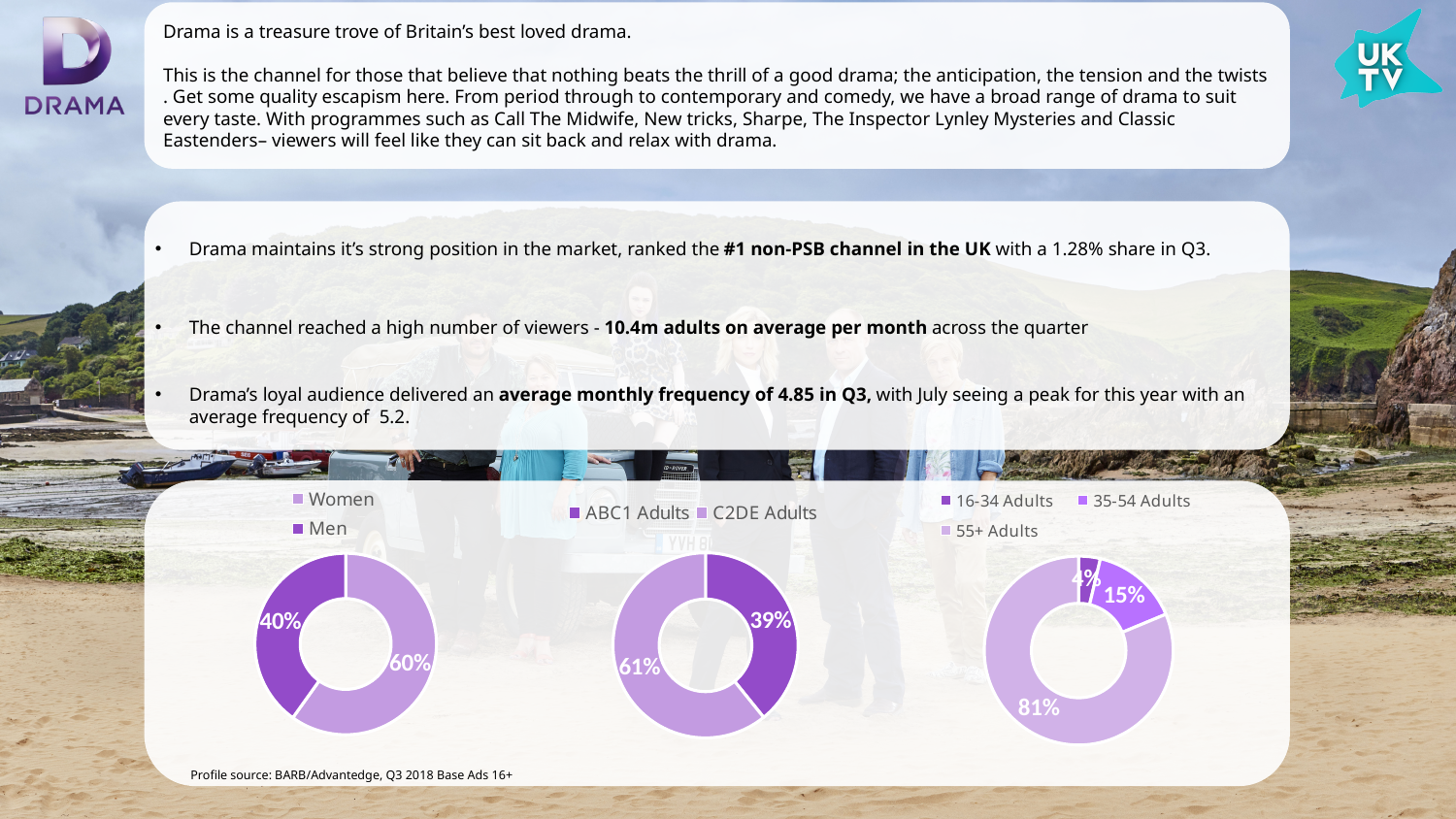
In the middle donut chart (ABC1/C2DE Adults), what share is shown for C2DE Adults? 61% In the right donut chart (age groups), what share is shown for 55+ Adults? 81% In the left donut chart (Women/Men), what share is shown for Women? 60% In the left donut chart (Women/Men), what share is shown for Men? 40% In the middle donut chart (ABC1/C2DE Adults), what share is shown for ABC1 Adults? 39% How many series does the legend of the right donut chart (age groups) list? 3 In the middle donut chart (ABC1/C2DE Adults), which group has the larger share, ABC1 Adults or C2DE Adults? C2DE Adults What type of chart is used for the three charts at the bottom of the slide? Donut (pie) chart In the right donut chart (age groups), which age group has the largest share? 55+ Adults In the left donut chart (Women/Men), what is the difference between the Women and Men shares? 20% In the right donut chart (age groups), what share is shown for 16-34 Adults? 4% In the right donut chart (age groups), which age group has the smallest share? 16-34 Adults